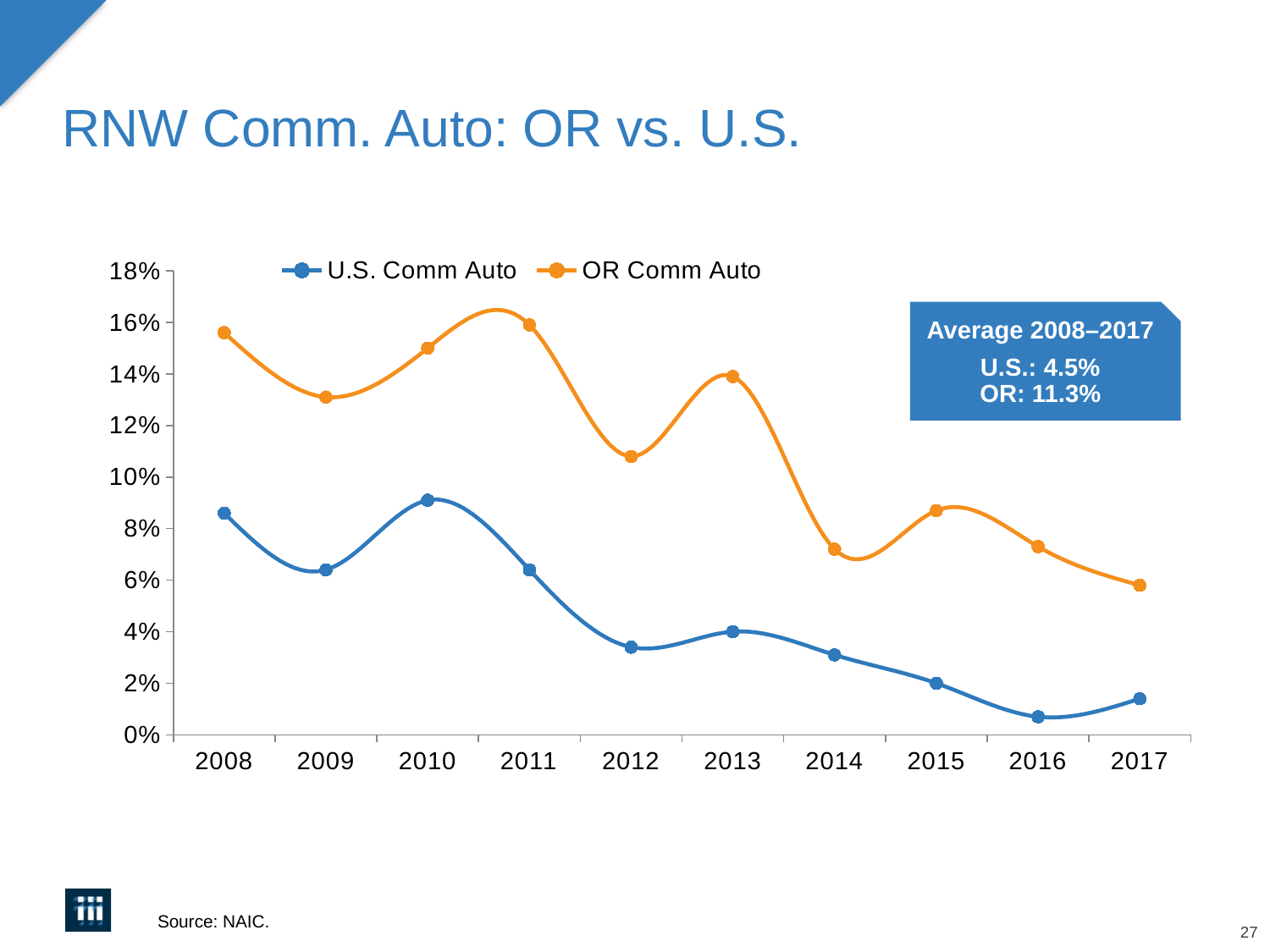
Does the U.S. Comm Auto series generally rise or fall from 2008 to 2017? fall How many years are plotted along the x axis? 10 How many series does the legend list? 2 In which year is the U.S. Comm Auto value lowest? 2016 Is the OR Comm Auto value for 2009 greater or less than 14%? less What is the average OR Comm Auto value for 2008–2017 shown in the text box? 11.3% Is the U.S. Comm Auto value for 2008 greater or less than 8%? greater In which year is the OR Comm Auto value lowest? 2017 What is the average U.S. Comm Auto value for 2008–2017 shown in the text box? 4.5% Is the OR Comm Auto value for 2012 greater or less than 10%? greater What kind of chart is shown on the slide? line chart In 2012, which series has the larger value, U.S. Comm Auto or OR Comm Auto? OR Comm Auto